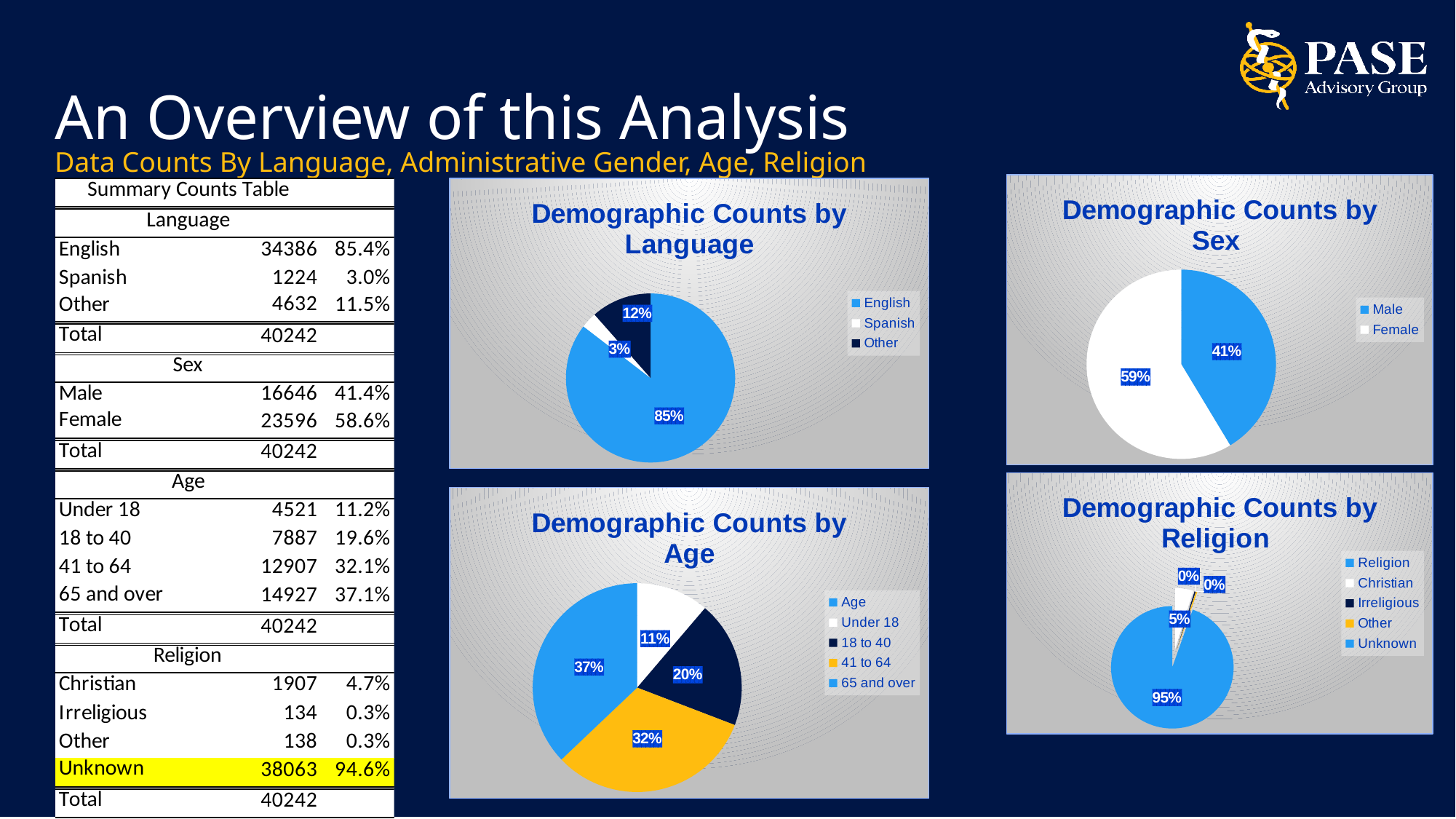
In the Demographic Counts by Sex chart, what is the difference between the Female and Male shares? 18% What kind of chart is the Demographic Counts by Sex chart? Pie chart How many entries does the legend of the Demographic Counts by Religion chart list? 5 In the Demographic Counts by Age chart, what share of the pie is 41 to 64? 32% In the Demographic Counts by Sex chart, which is larger, the Male slice or the Female slice? Female In the Demographic Counts by Religion chart, what share of the pie is Unknown? 95% In the Demographic Counts by Language chart, what share of the pie is Spanish? 3% In the Demographic Counts by Age chart, which age group has the largest slice? 65 and over In the Demographic Counts by Age chart, which age group has the smallest slice? Under 18 In the Demographic Counts by Language chart, which category has the smallest slice? Spanish